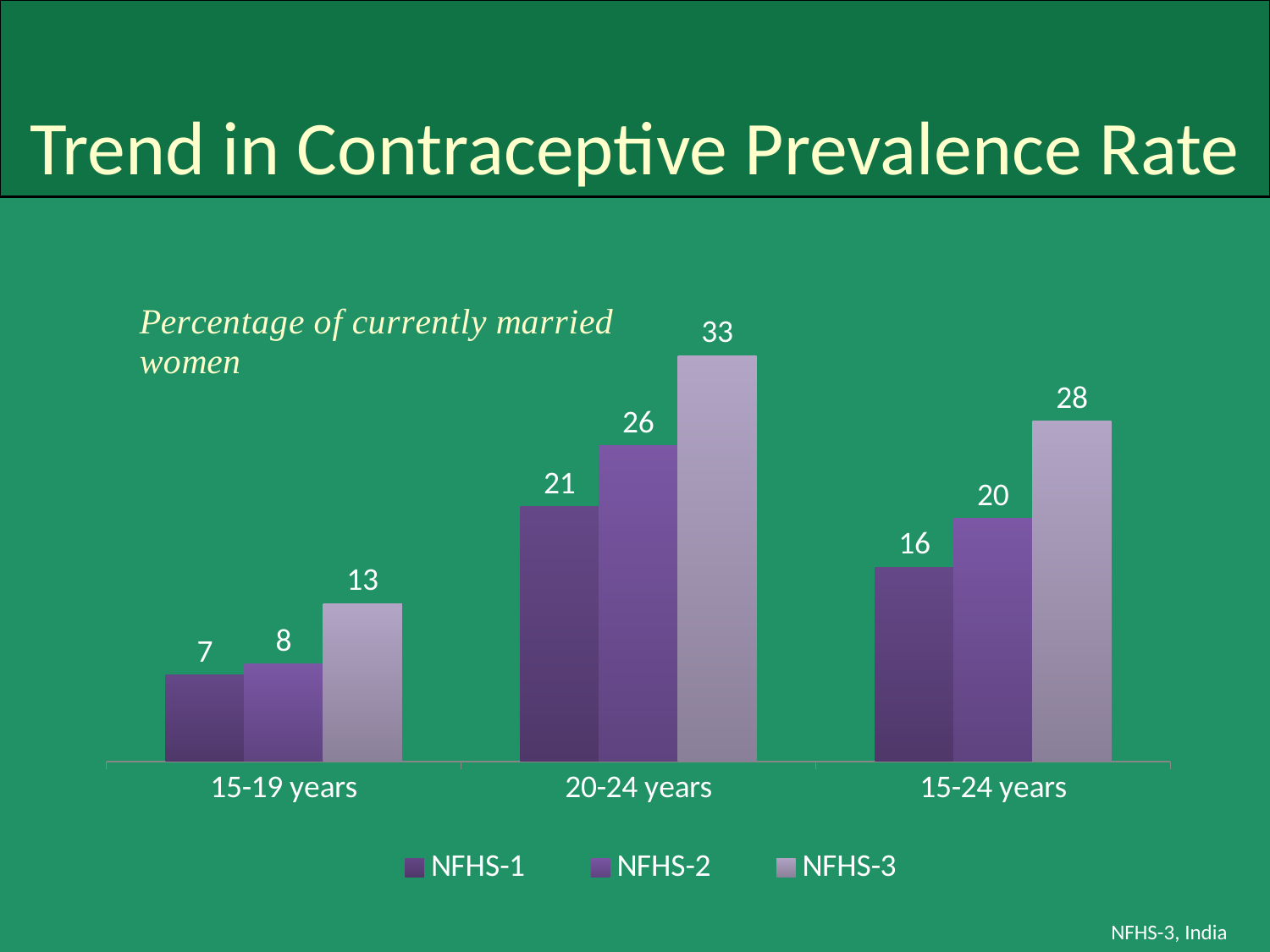
What is the NFHS-1 value for the 15-19 years group? 7 Which age group has the highest NFHS-3 value? 20-24 years How many age groups are shown on the x axis? 3 Do the values for the 15-19 years group rise or fall from NFHS-1 to NFHS-3? Rise How many series does the legend list? 3 What is the NFHS-2 value for the 15-24 years group? 20 What kind of chart is shown on the slide? Bar chart Which is larger for the 15-24 years group: the NFHS-2 value or the NFHS-3 value? NFHS-3 Which age group has the lowest NFHS-1 value? 15-19 years What is the NFHS-3 value for the 20-24 years group? 33 What is the difference between the NFHS-3 and NFHS-1 values for the 20-24 years group? 12 What is the difference between the NFHS-3 values for the 15-24 years and 15-19 years groups? 15